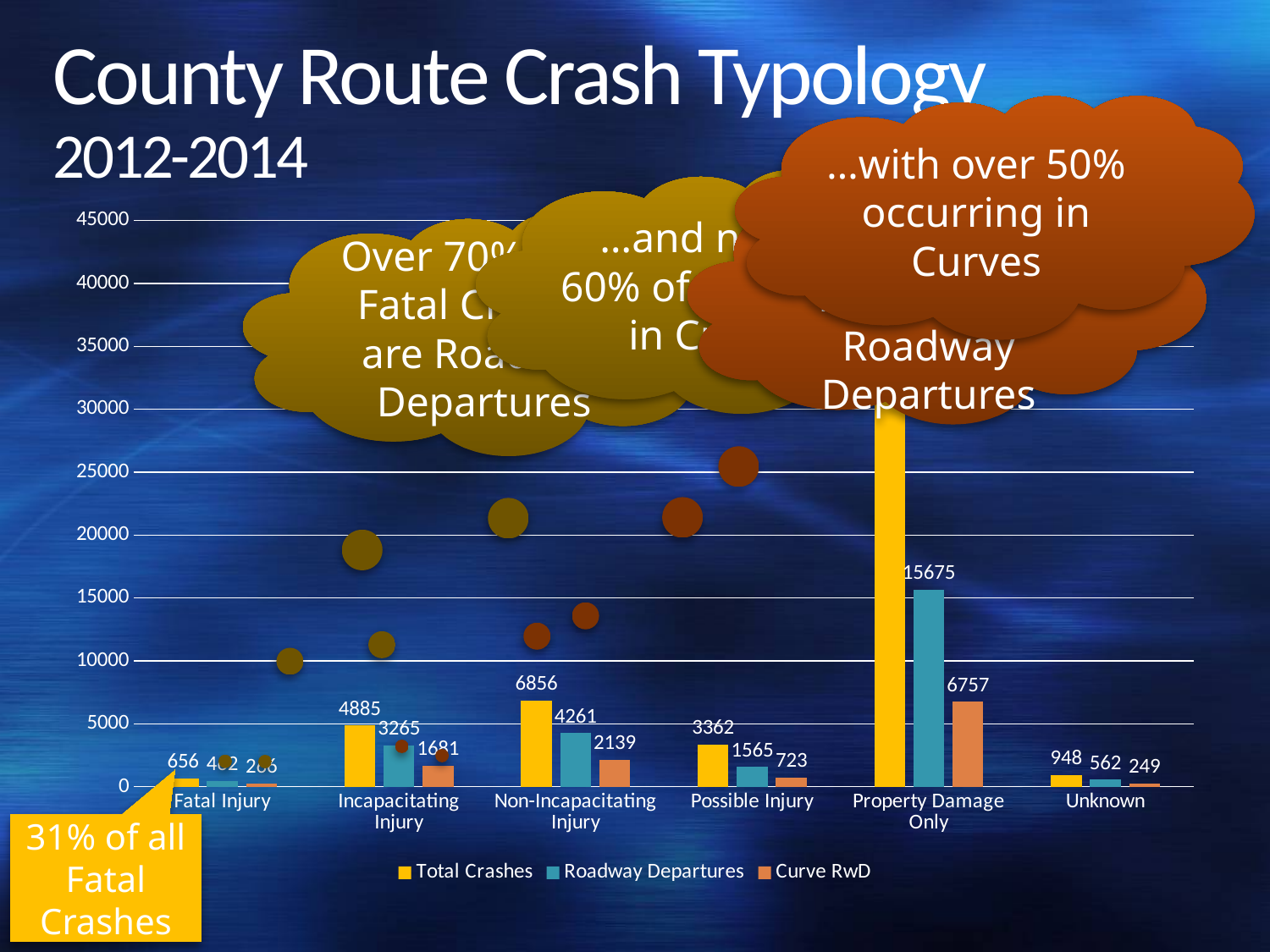
What is the difference between Total Crashes and Roadway Departures for Possible Injury? 1797 What is the Roadway Departures value for Property Damage Only? 15675 What is the Curve RwD value for Incapacitating Injury? 1681 What type of chart is shown on the slide? bar chart How many crash categories are shown on the x axis? 6 Which is larger, the Curve RwD value for Non-Incapacitating Injury or for Possible Injury? Non-Incapacitating Injury How many series does the legend list? 3 Which category has the highest Roadway Departures value? Property Damage Only Which category has the lowest Curve RwD value? Unknown What is the Total Crashes value for Non-Incapacitating Injury? 6856 Is the Total Crashes value for Property Damage Only greater or less than 25000? greater What is the Total Crashes value for Unknown? 948